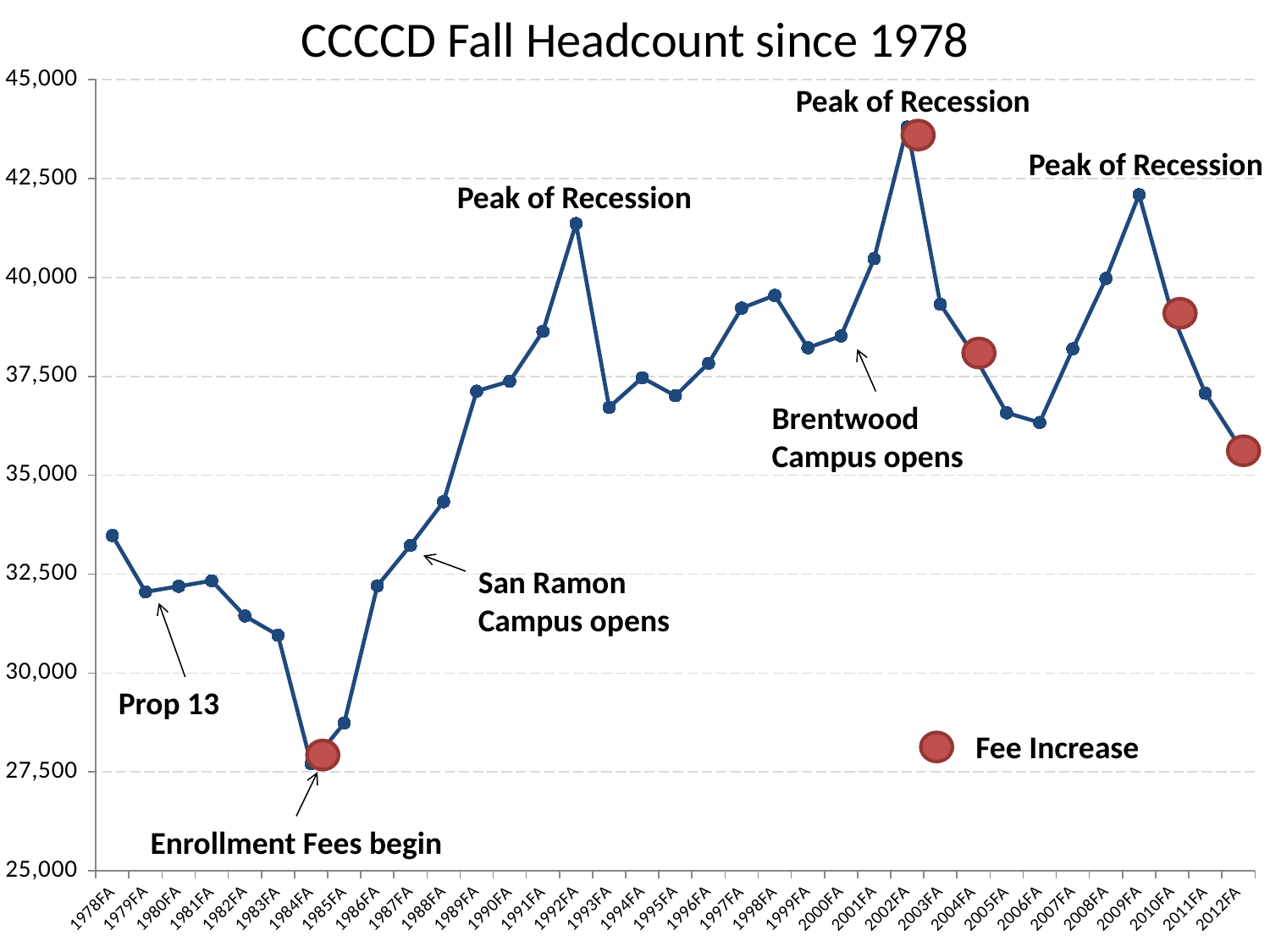
Which has the larger headcount, 2002FA or 1992FA? 2002FA Which fall term has the lowest headcount? 1984FA Is the headcount for 1992FA greater or less than 40,000? greater Is the headcount for 2012FA greater or less than 35,000? greater Does the headcount rise or fall from 2009FA to 2012FA? fall Is the headcount for 2006FA greater or less than 37,500? less What is the title of the chart? CCCCD Fall Headcount since 1978 What do the red circles on the chart mark? Fee Increase How many fall terms are plotted on the x axis? 35 Which fall term has the highest headcount? 2002FA What kind of chart is shown on the slide? line chart